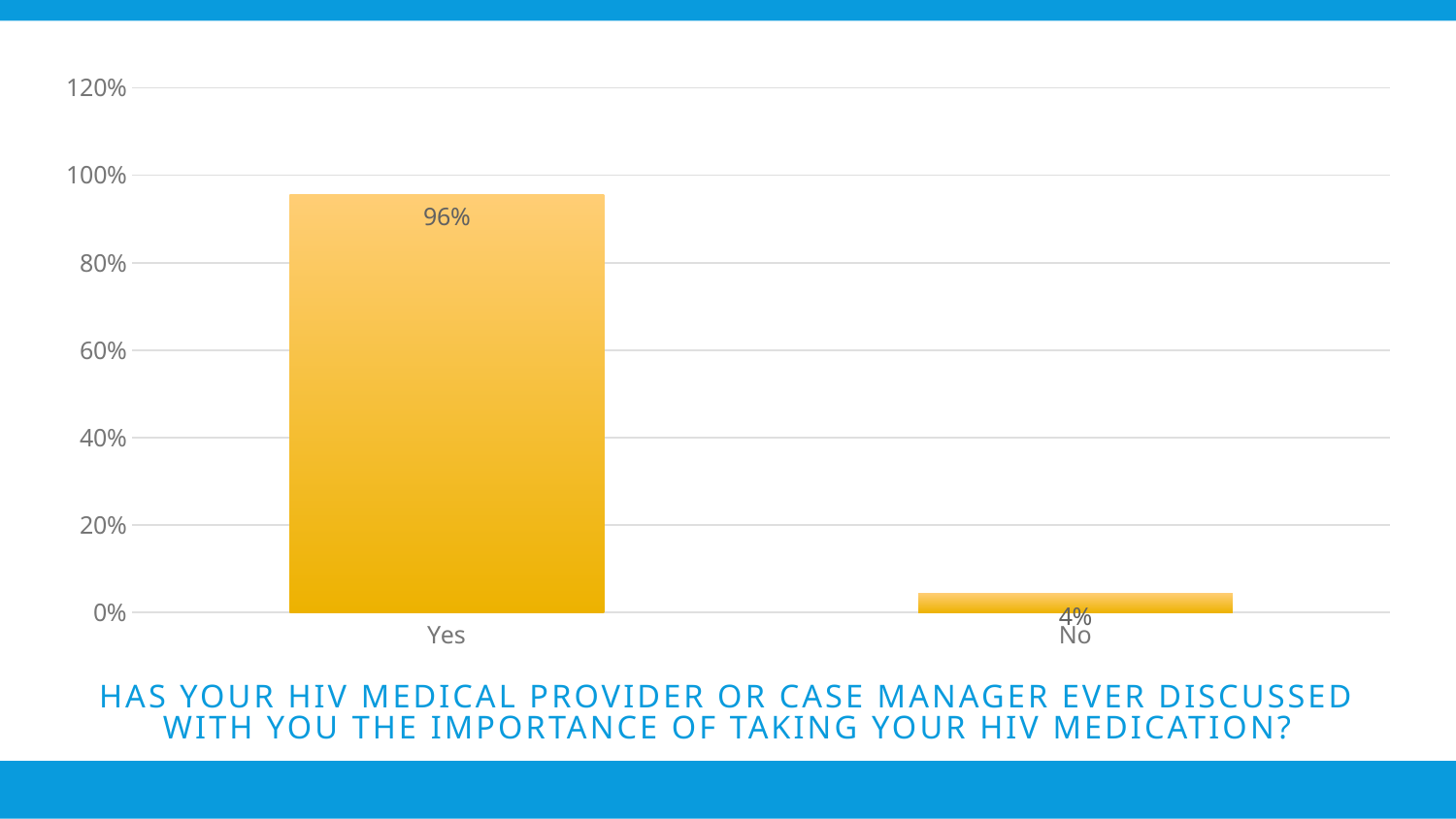
What is the highest value shown on the y axis? 120% Which category has the lowest value? No What kind of chart is shown on the slide? bar chart What percentage of respondents answered No? 4% What percentage of respondents answered Yes? 96% Is the value for No greater or less than 20%? less What is the difference between the Yes and No percentages? 92% Which is larger, the value for Yes or the value for No? Yes How many categories are shown on the x axis? 2 Which category has the highest value? Yes What question does the chart title ask? Has your HIV medical provider or case manager ever discussed with you the importance of taking your HIV medication? Is the value for Yes greater or less than 80%? greater